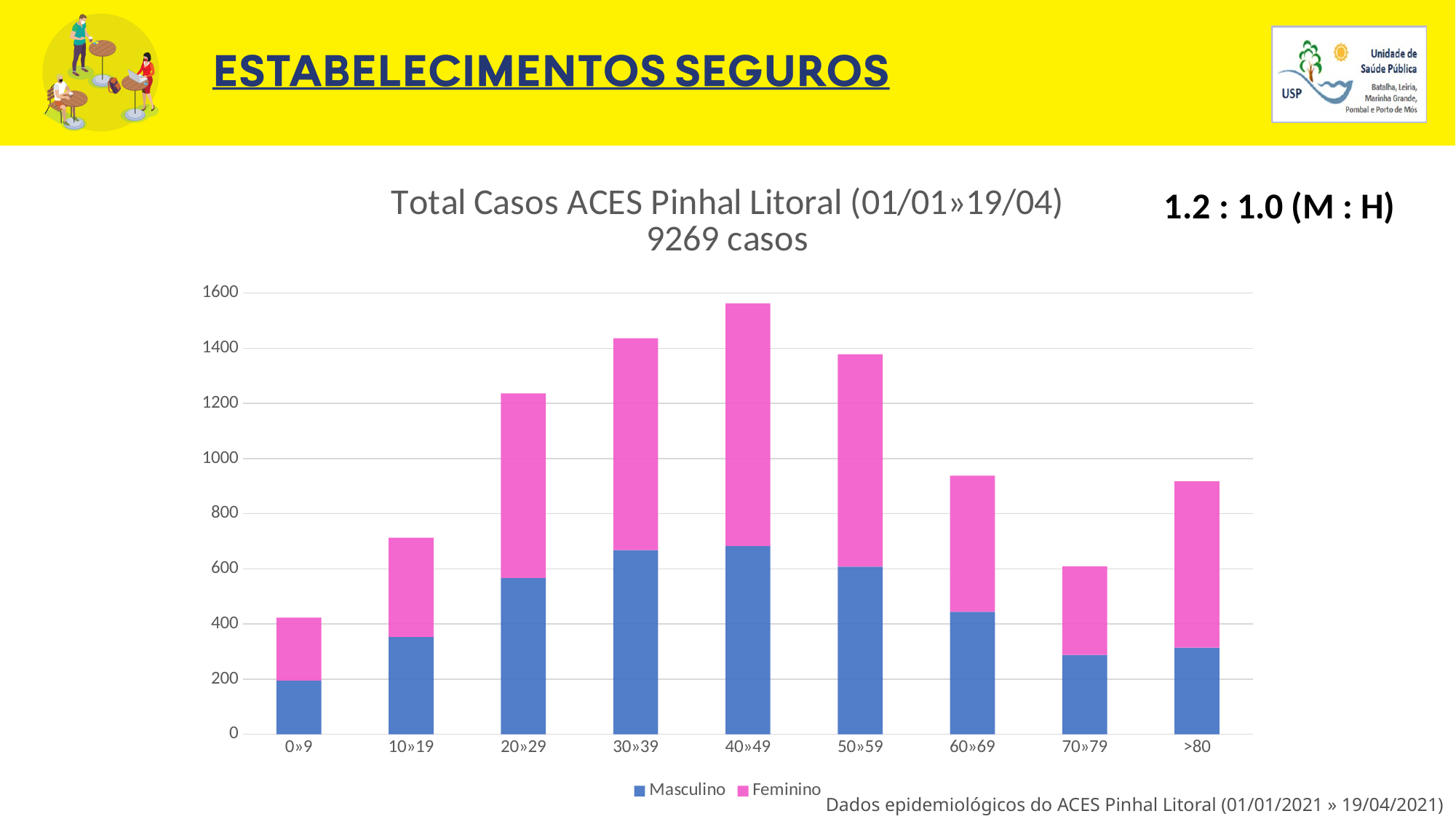
How many age groups are shown on the x axis of the chart? 9 Is the total stacked bar for the 0»9 age group greater or less than 600? less Which series is shown in pink in the chart? Feminino Which has a taller total bar, the 20»29 age group or the 60»69 age group? 20»29 According to the chart title, how many total cases are represented? 9269 casos Which age group has the tallest stacked bar (highest total cases)? 40»49 How many series does the chart legend list? 2 Is the total stacked bar for the 40»49 age group greater or less than 1400? greater Is the total stacked bar for the 70»79 age group greater or less than 800? less What kind of chart is shown on the slide? stacked bar chart Which age group has the shortest stacked bar (lowest total cases)? 0»9